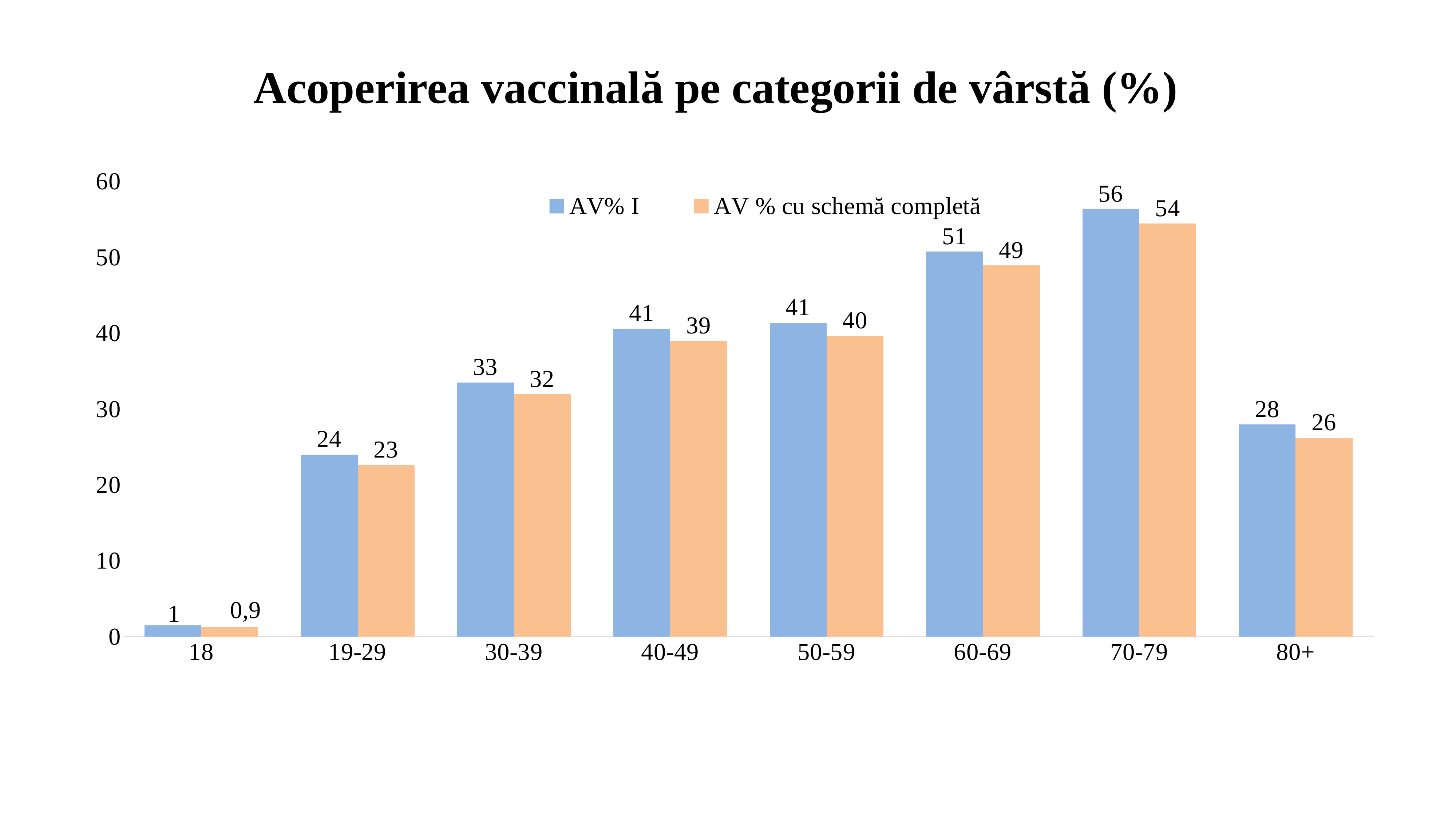
How many series does the legend list? 2 Which age group has the highest AV% I value? 70-79 What is the AV % cu schemă completă value for the 18 age group? 0,9 What is the AV % cu schemă completă value for the 40-49 age group? 39 What is the AV% I value for the 70-79 age group? 56 Which age group has the lowest AV % cu schemă completă value? 18 Is the AV % cu schemă completă value for 50-59 greater or less than 30? greater What is the title of the chart? Acoperirea vaccinală pe categorii de vârstă (%) How many age groups are shown on the x axis? 8 What is the difference between the AV% I and AV % cu schemă completă values for the 60-69 age group? 2 What kind of chart is shown on the slide? bar chart Which is larger: the AV% I value for 30-39 or the AV% I value for 80+? 30-39